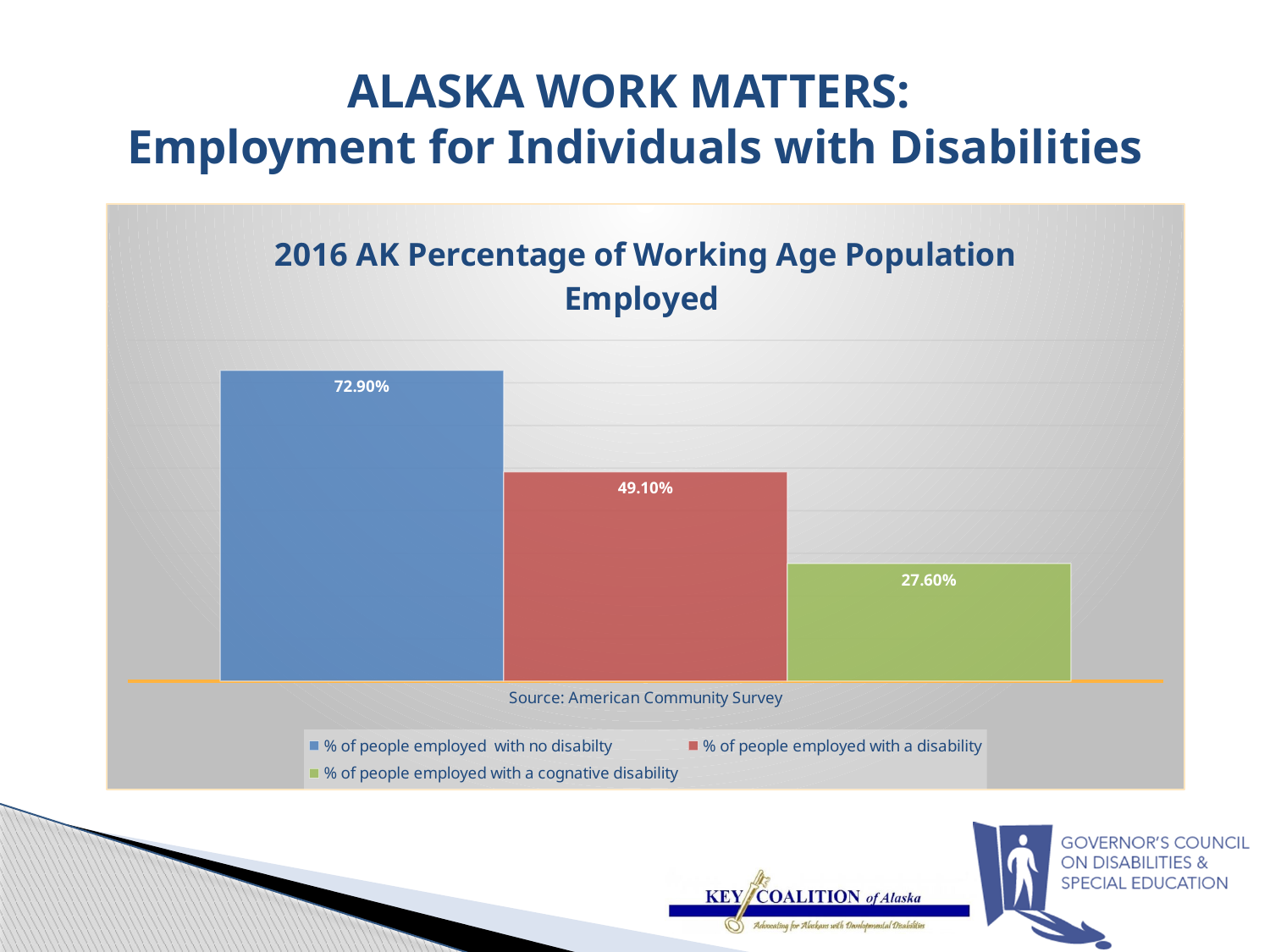
How many bars are plotted on the chart? 3 Which is larger: the percentage employed with a disability or the percentage employed with a cognitive disability? % of people employed with a disability What is the title of the chart? 2016 AK Percentage of Working Age Population Employed Which series has the lowest value on the chart? % of people employed with a cognative disability What is the difference between the percentage employed with a disability and the percentage employed with a cognitive disability? 21.50% What percentage of people employed with a cognitive disability is shown on the chart? 27.60% What is the difference between the percentage employed with no disability and the percentage employed with a disability? 23.80% What percentage of people employed with no disability is shown on the chart? 72.90% What kind of chart is shown on the slide? Bar chart How many series does the legend list? 3 Which series has the highest value on the chart? % of people employed with no disabilty What percentage of people employed with a disability is shown on the chart? 49.10%